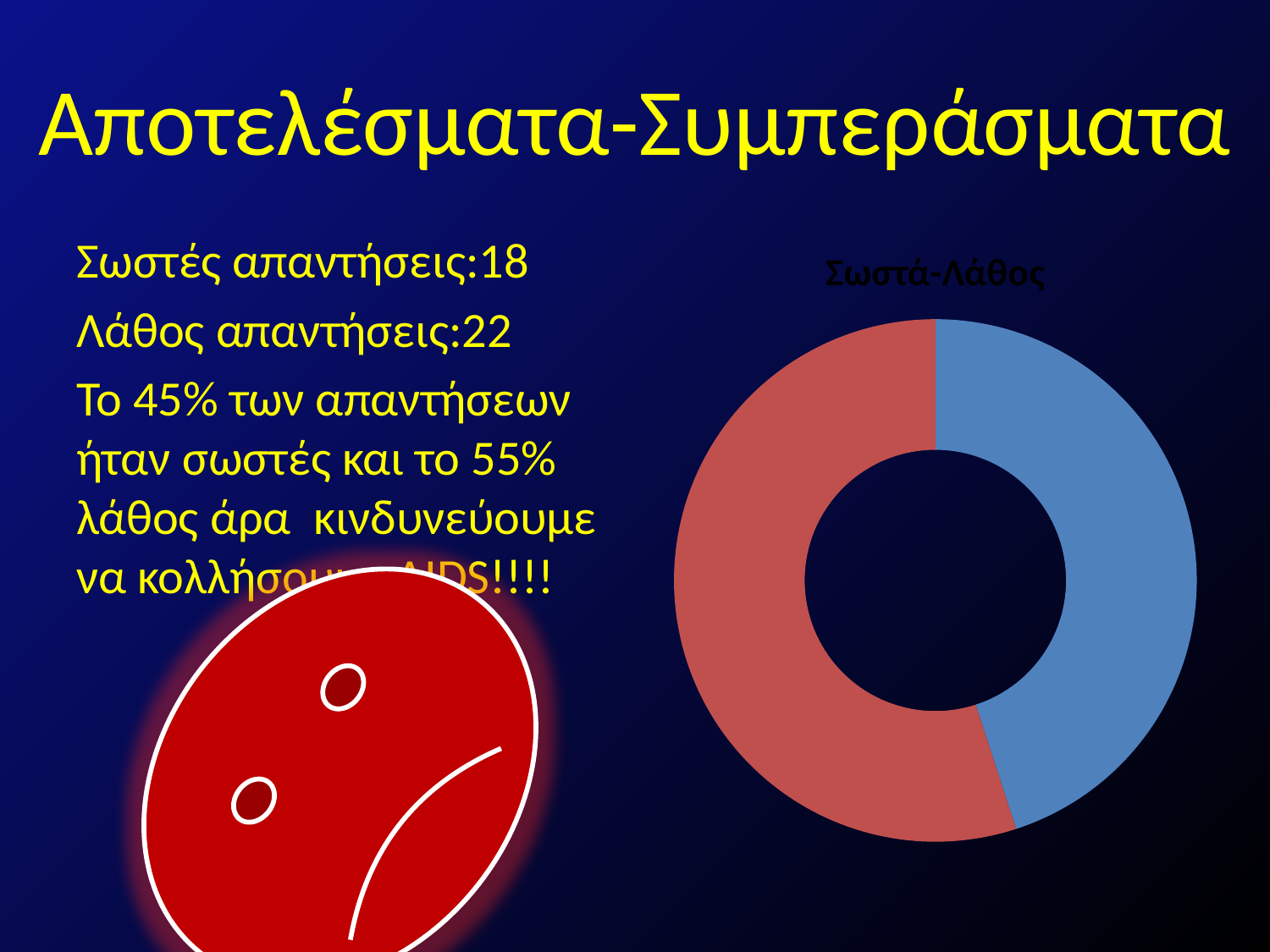
What is the title of the chart on the slide? Σωστά-Λάθος How many slices does the chart have? 2 What kind of chart is shown on the slide? doughnut chart Which slice of the chart is larger, the red one or the blue one? red What two colours are used for the slices of the chart? red and blue